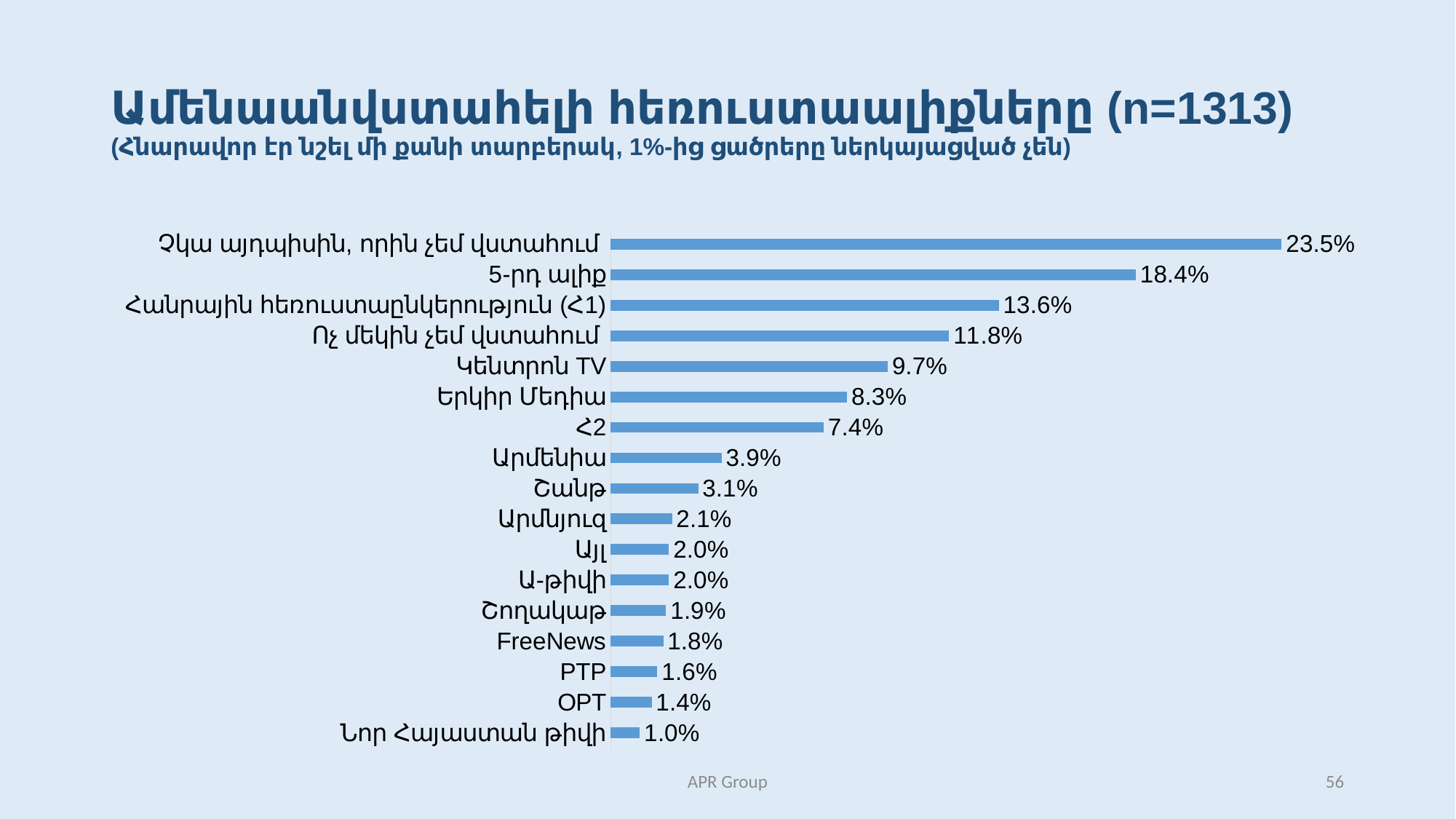
Which has a larger value, Շանթ or Արմնյուզ? Շանթ What value is shown for Կենտրոն TV? 9.7% What is the difference between the values for 5-րդ ալիք and Հանրային հեռուստաընկերություն (Հ1)? 4.8% What sample size (n) is given in the chart title? n=1313 Which category has the lowest value? Նոր Հայաստան թիվի What value is shown for FreeNews? 1.8% What value is shown for Հ2? 7.4% How many categories are shown in the chart? 17 Which category has the highest value? Չկա այդպիսին, որին չեմ վստահում What kind of chart is shown on the slide? Bar chart What value is shown for 5-րդ ալիք? 18.4% What is the difference between the values for Երկիր Մեդիա and Արմենիա? 4.4%